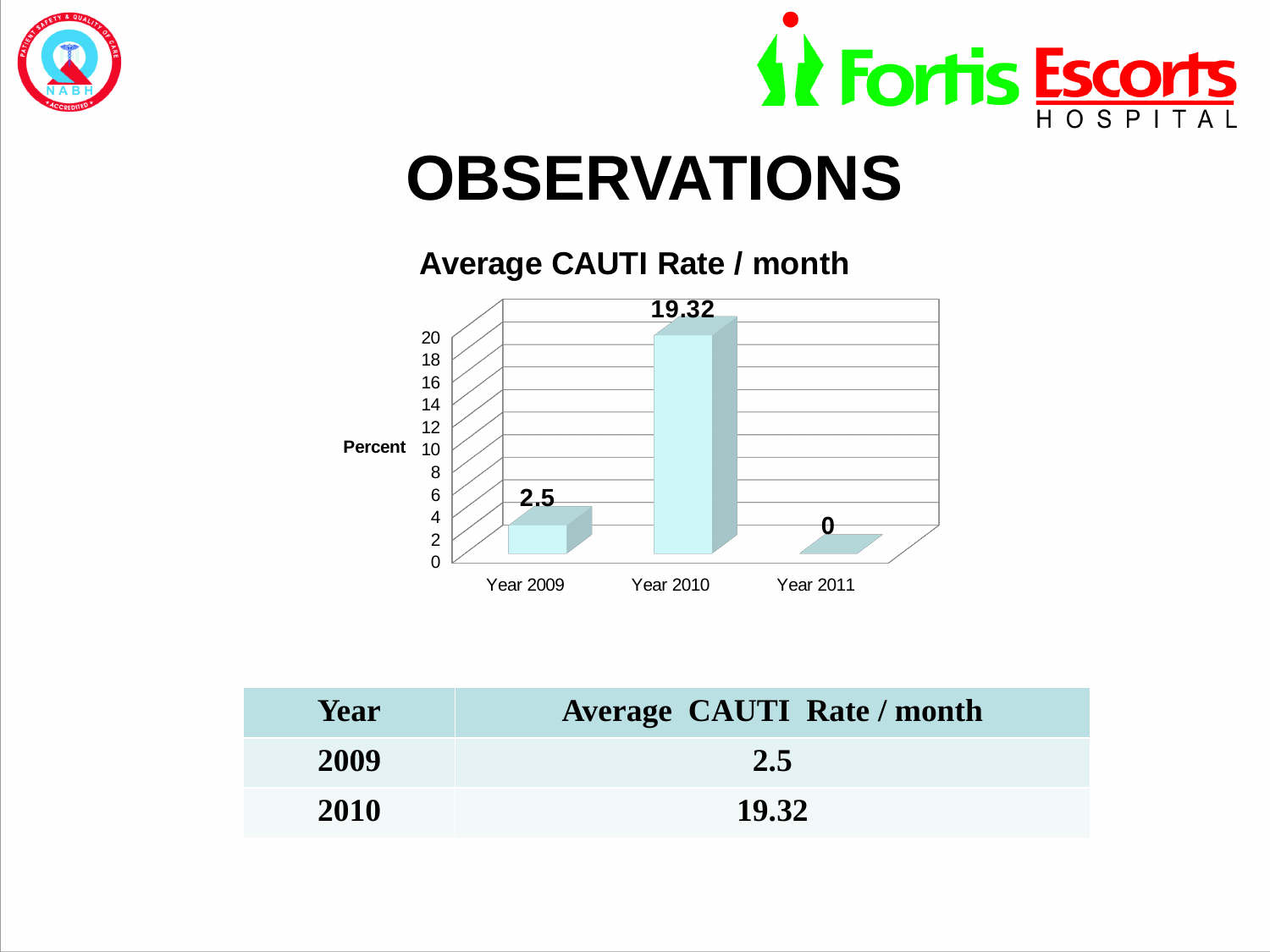
What is the value for Year 2011 in the Average CAUTI Rate / month chart? 0 What kind of chart is shown on the slide? bar chart Which is larger, the value for Year 2009 or Year 2011? Year 2009 How many years are shown on the x axis of the chart? 3 What is the difference between the values for Year 2010 and Year 2009? 16.82 Is the value for Year 2010 greater or less than 10? greater What is the label of the vertical axis of the chart? Percent What is the value for Year 2010 in the Average CAUTI Rate / month chart? 19.32 Which year has the lowest Average CAUTI Rate / month? Year 2011 What is the title of the chart? Average CAUTI Rate / month Which year has the highest Average CAUTI Rate / month? Year 2010 What is the value for Year 2009 in the Average CAUTI Rate / month chart? 2.5